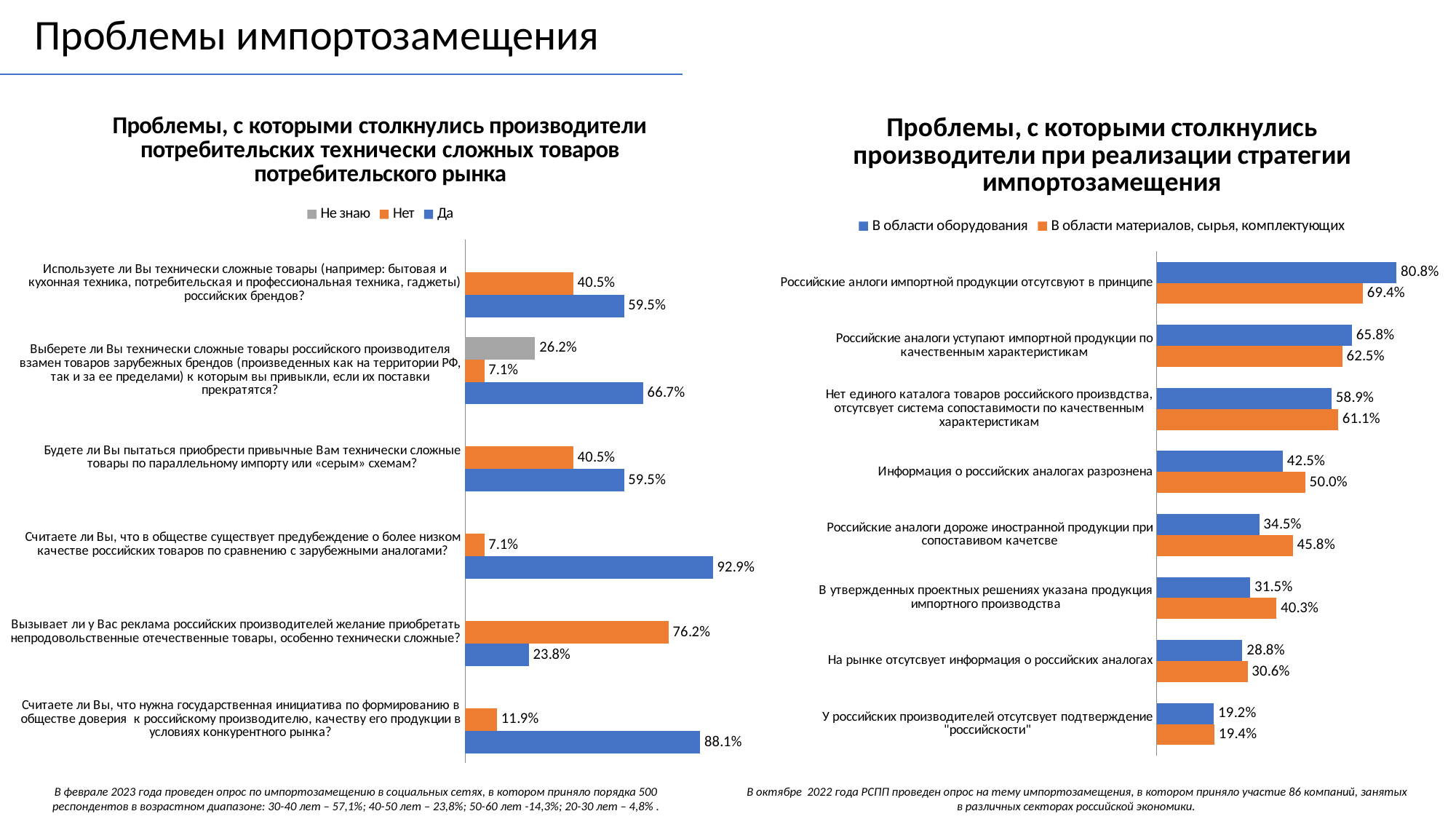
On the right chart, how many categories are shown? 8 On the right chart, which category has the highest value for "В области оборудования"? Российские анлоги импортной продукции отсутсвуют в принципе On the right chart, for "Российские аналоги дороже иностранной продукции при сопоставивом качетсве", which series has the larger value? В области материалов, сырья, комплектующих On the left chart, what percentage answered "Да" to whether society has a prejudice about lower quality of Russian goods compared to foreign analogues? 92.9% On the right chart, what is the value for "В области материалов, сырья, комплектующих" for "Информация о российских аналогах разрознена"? 50.0% On the left chart, what is the "Не знаю" value for the question about choosing Russian-made technically complex goods instead of foreign brands if supplies stop? 26.2% On the left chart, how many series does the legend list? 3 On the right chart, which category has the lowest value for "В области материалов, сырья, комплектующих"? У российских производителей отсутствует подтверждение "российскости" On the left chart, what is the difference between the "Да" and "Нет" values for the question about a state initiative to build trust in Russian producers? 76.2 percentage points On the left chart, what is the "Нет" value for whether advertising by Russian producers creates a desire to buy domestic non-food goods? 76.2% On the right chart, what is the value for "В области оборудования" for "Российские анлоги импортной продукции отсутсвуют в принципе"? 80.8% What type of chart is the right chart? Bar chart